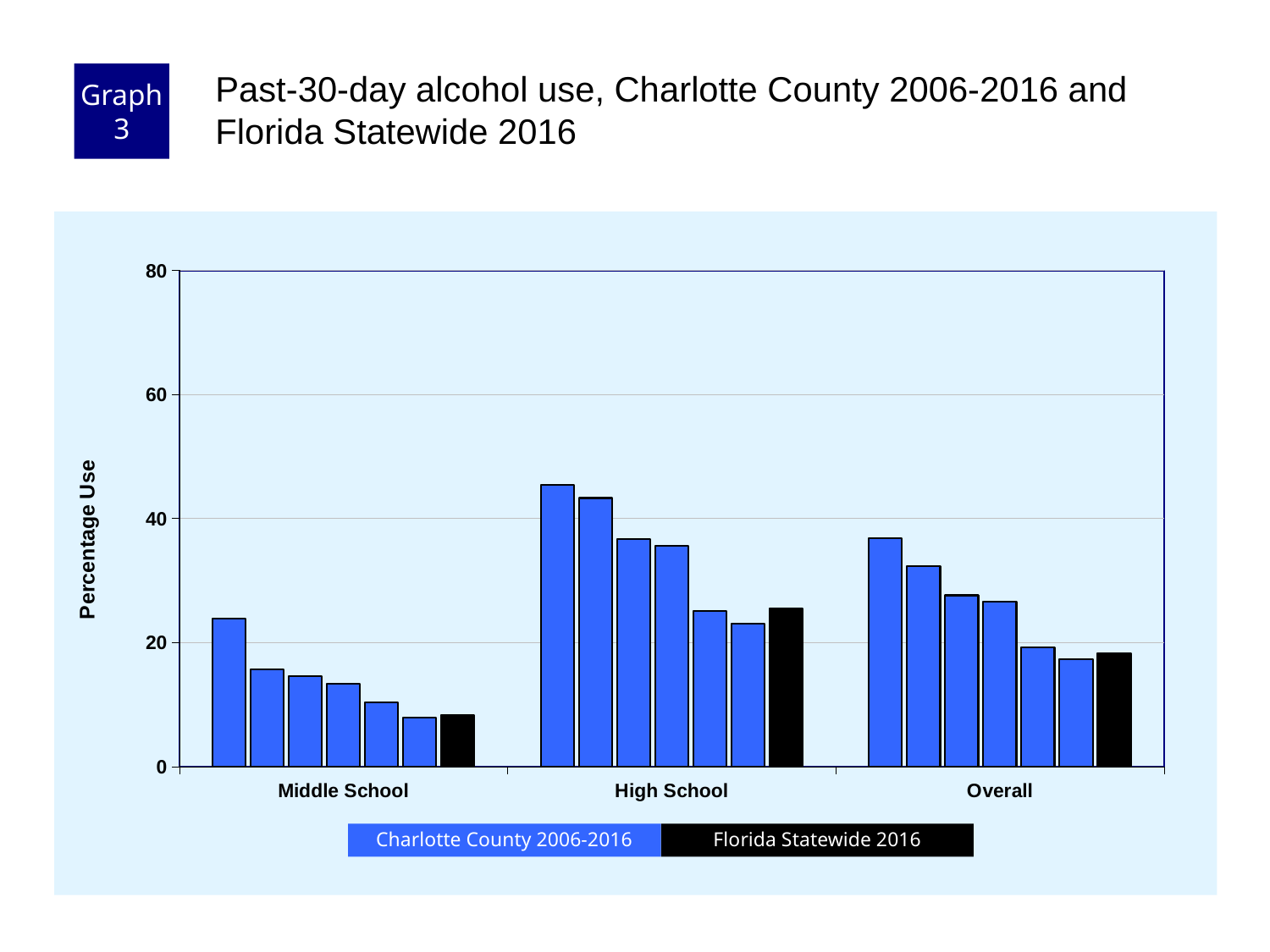
How many series does the legend list? 2 Do the Charlotte County bars within each category rise or fall from left to right? fall Which category has the shortest bars overall? Middle School Which is larger, the Florida Statewide 2016 value for High School or for Middle School? High School Which category has the tallest bars overall? High School Is the Florida Statewide 2016 bar for High School greater or less than 20? greater How many categories are shown along the x axis? 3 Is the first Charlotte County bar for Middle School greater or less than 20? greater What kind of chart is shown on the slide? bar chart Is the first Charlotte County bar for High School greater or less than 40? greater What is the label on the y axis? Percentage Use